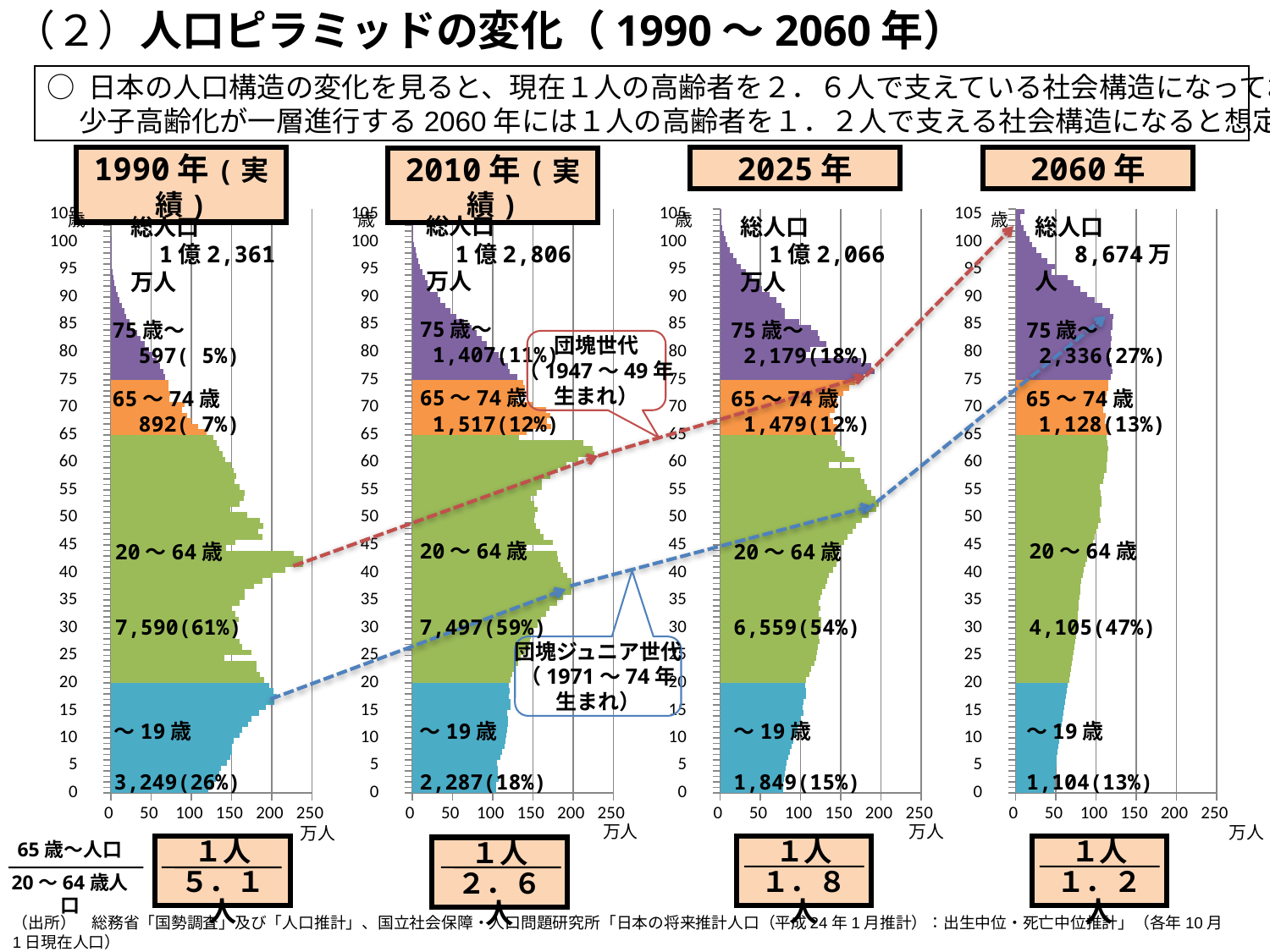
In the 2060年 chart, which age group has the largest printed population? 20～64歳 In the 1990年 chart, what is the printed value for the 20～64歳 group? 7,590(61%) In the 2025年 chart, what is the printed total population (総人口)? 1億2,066万人 In the 2060年 chart, what is the printed value for the 75歳～ group? 2,336(27%) What is the difference between the 20～64歳 population in the 1990年 chart (7,590) and in the 2060年 chart (4,105)? 3,485 Which is larger: the 75歳～ population in the 2025年 chart or in the 2060年 chart? 2060年 How many age groups are shown in each population pyramid chart? 4 What kind of chart is used to show the population by age in each year? Bar chart (population pyramid) How does the share of the ～19歳 group change across the charts from 1990年 to 2060年? It falls (26% to 13%) What is the ratio of 20～64歳 people per 65歳～ person shown below the 2010年 chart? 1人 / 2.6人 In the 2010年 chart, what is the printed value for the ～19歳 group? 2,287(18%) In the 1990年 chart, which age group has the smallest printed population? 75歳～